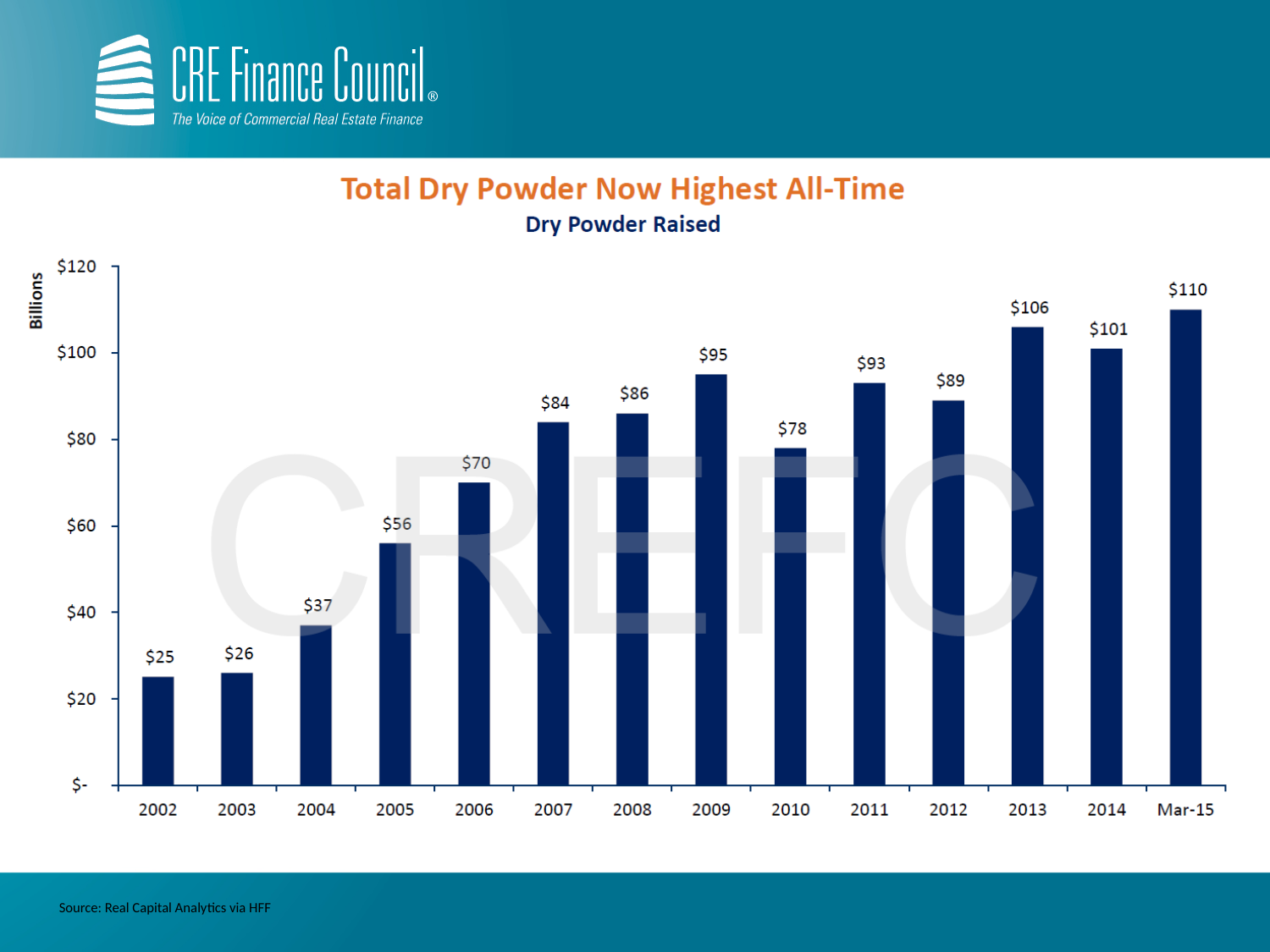
What is the value for 2002 in the Dry Powder Raised chart? $25 Which category has the lowest value in the Dry Powder Raised chart? 2002 What is the difference between the values for 2013 and 2014 in the Dry Powder Raised chart? $5 Which is larger in the Dry Powder Raised chart, the value for 2010 or the value for 2008? 2008 What is the value for 2009 in the Dry Powder Raised chart? $95 What is the title of the chart on the slide? Dry Powder Raised Do the values in the Dry Powder Raised chart generally rise or fall from 2002 to Mar-15? rise Is the value for 2012 greater or less than $80 in the Dry Powder Raised chart? greater How many categories are shown on the x axis of the Dry Powder Raised chart? 14 What kind of chart is the Dry Powder Raised chart? bar chart Which category has the highest value in the Dry Powder Raised chart? Mar-15 What is the value for Mar-15 in the Dry Powder Raised chart? $110